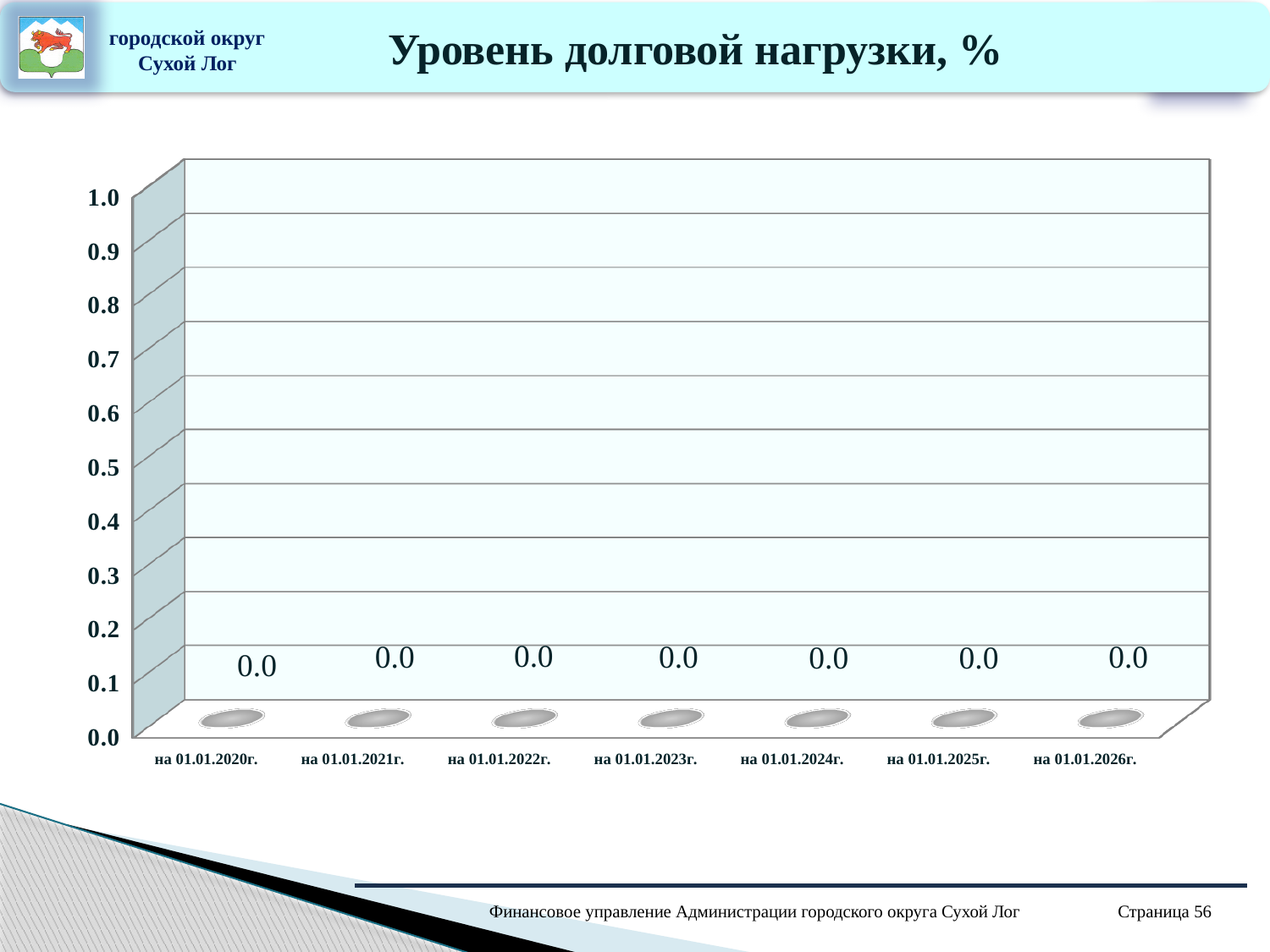
What is the value for на 01.01.2022г.? 0.0 What is the value for на 01.01.2023г.? 0.0 What is the value for на 01.01.2020г.? 0.0 What kind of chart is shown on the slide? bar chart What is the highest value shown on the y axis? 1.0 What is the value for на 01.01.2026г.? 0.0 What is the title of the chart? Уровень долговой нагрузки, % Do the values rise, fall, or stay the same from на 01.01.2020г. to на 01.01.2026г.? stay the same How many categories (dates) are shown on the x axis? 7 What is the value for на 01.01.2021г.? 0.0 What is the difference between the values for на 01.01.2025г. and на 01.01.2020г.? 0.0 Is the value for на 01.01.2024г. greater or less than 0.5? less